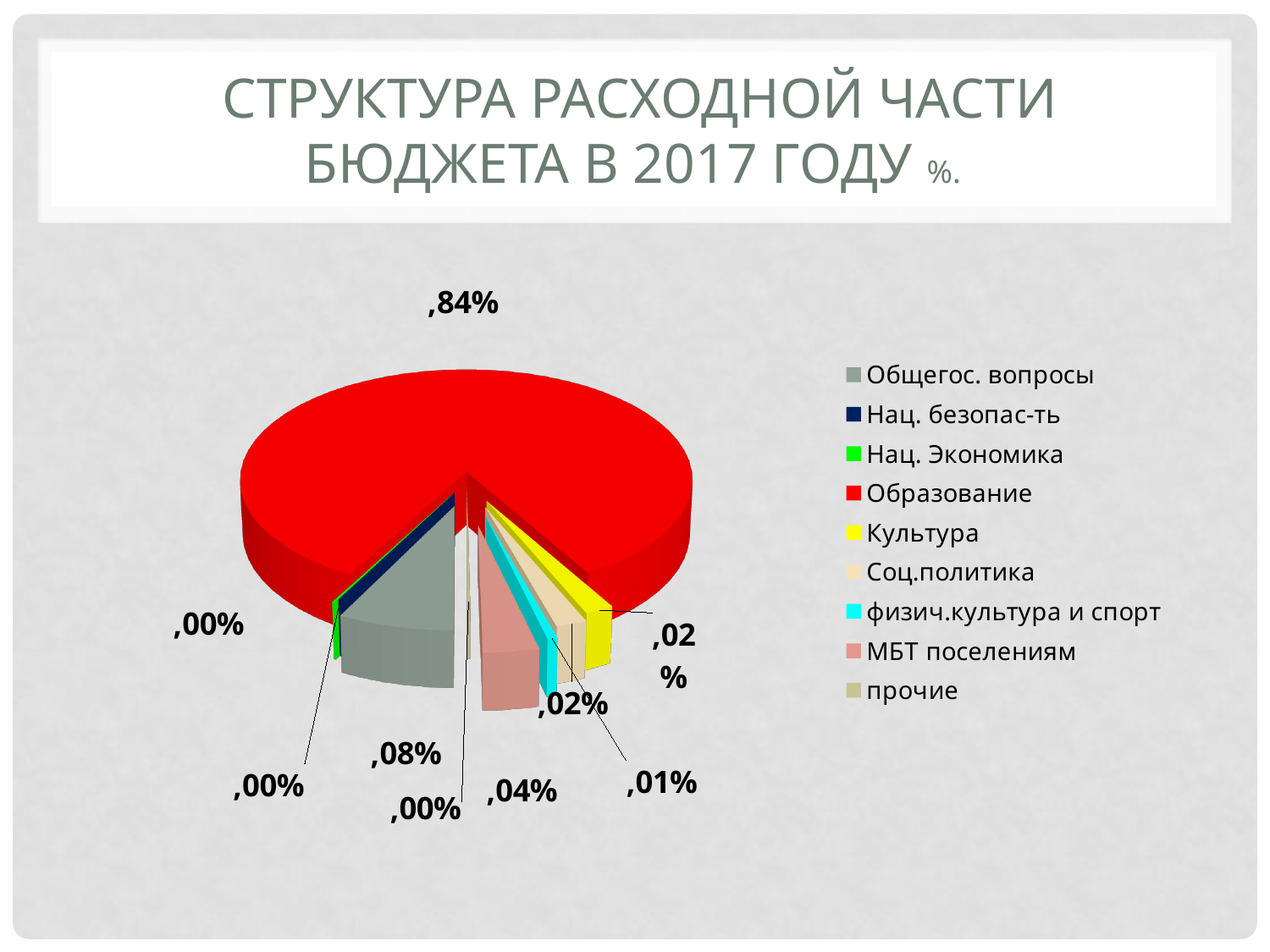
What value is shown for МБТ поселениям? ,04% What is the title of the chart on the slide? СТРУКТУРА РАСХОДНОЙ ЧАСТИ БЮДЖЕТА В 2017 ГОДУ %. What kind of chart is shown on the slide? pie chart How many categories does the legend of the pie chart list? 9 What value is shown for Соц.политика? ,02% Which category has the largest slice of the pie? Образование What value is shown for Культура? ,02% By how many percentage points does Образование exceed Общегос. вопросы? 76% Which is larger, the slice for Общегос. вопросы or the slice for Культура? Общегос. вопросы What colour is the slice for Образование? red What share of the pie does Образование take? ,84% What value is shown for Общегос. вопросы? ,08%